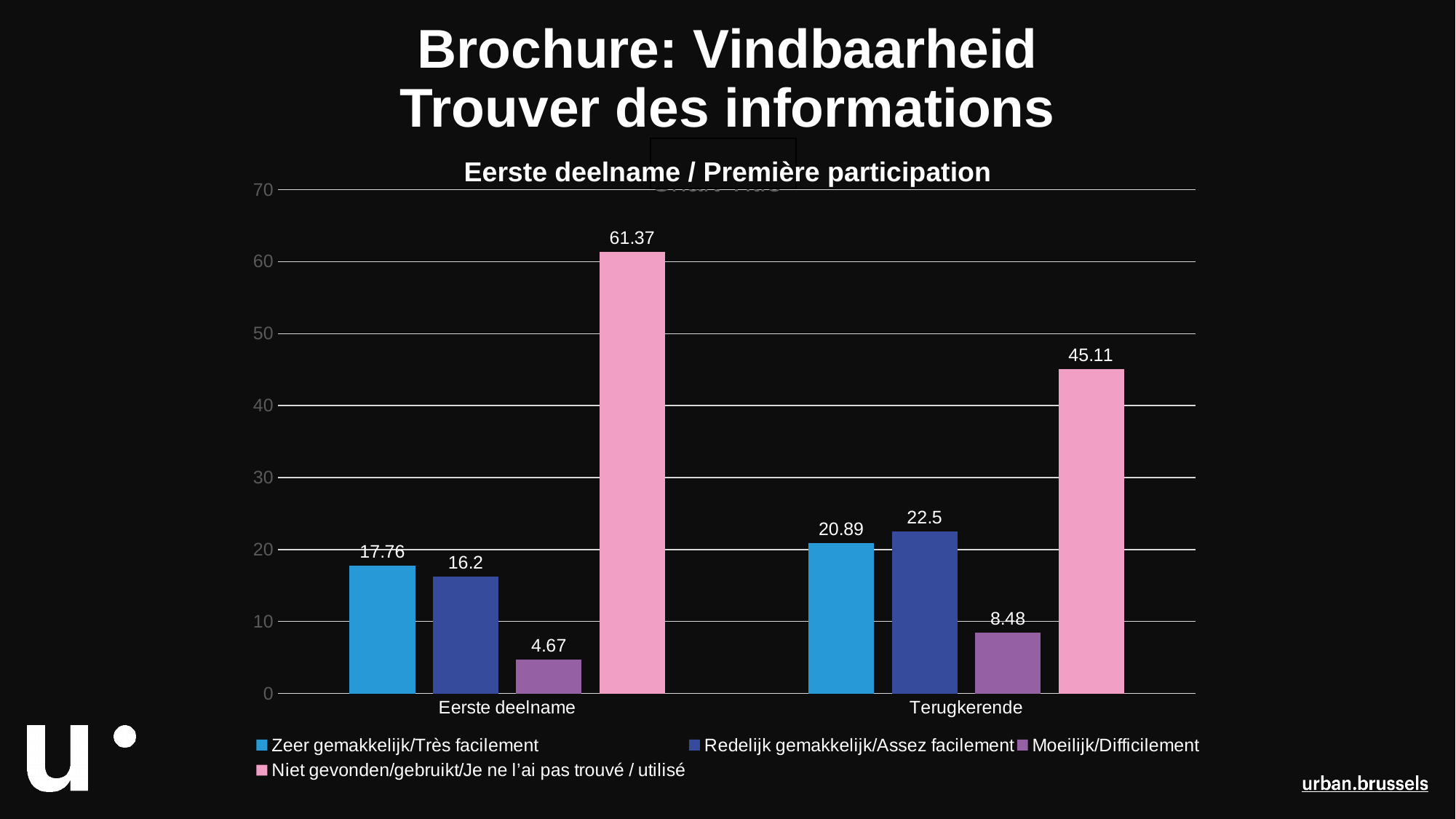
What is the difference between the Niet gevonden/gebruikt values for Eerste deelname and Terugkerende? 16.26 What is the value for Redelijk gemakkelijk/Assez facilement in the Terugkerende category? 22.5 How many series does the legend list? 4 What is the value for Niet gevonden/gebruikt/Je ne l'ai pas trouvé / utilisé in the Eerste deelname category? 61.37 What is the value for Moeilijk/Difficilement in the Eerste deelname category? 4.67 Which series has the lowest value in the Eerste deelname category? Moeilijk/Difficilement What kind of chart is shown on the slide? Bar chart Which series has the highest value in the Terugkerende category? Niet gevonden/gebruikt/Je ne l'ai pas trouvé / utilisé What is the value for Zeer gemakkelijk/Très facilement in the Terugkerende category? 20.89 Is the value for Moeilijk/Difficilement in the Terugkerende category greater or less than 10? less How many categories are shown on the x axis? 2 Which is larger: Zeer gemakkelijk/Très facilement for Eerste deelname or for Terugkerende? Terugkerende